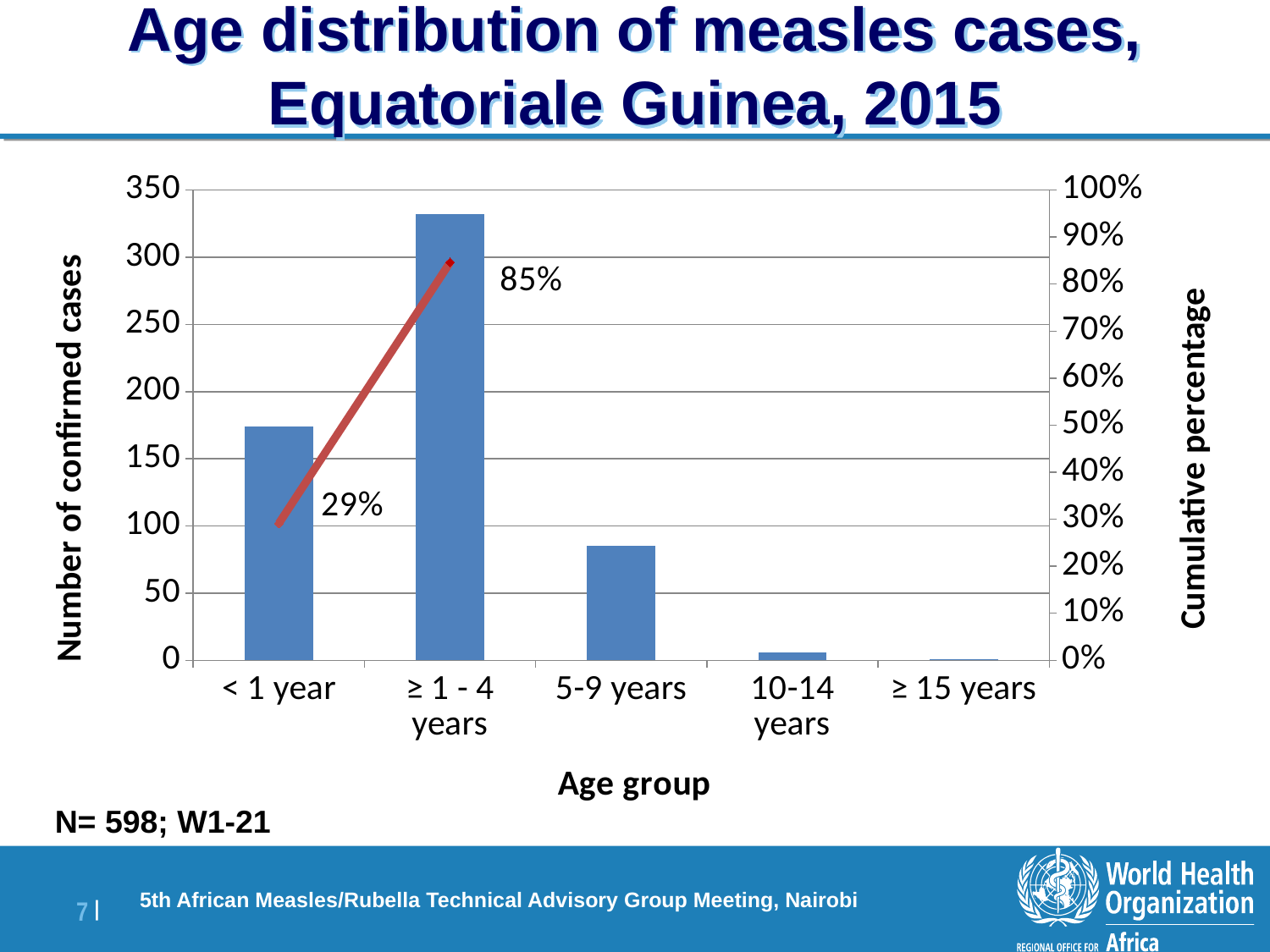
Is the number of confirmed cases for ≥ 1 - 4 years greater or less than 300? greater What is the difference between the cumulative percentages at ≥ 1 - 4 years and < 1 year? 56% Which age group has the highest number of confirmed cases? ≥ 1 - 4 years What kind of chart is shown on the slide? bar chart with a line Is the number of confirmed cases for < 1 year greater or less than 150? greater What is the cumulative percentage shown for the < 1 year age group? 29% How many age groups are shown on the x axis? 5 What is the title of the right-hand vertical axis? Cumulative percentage Which age group has the lowest number of confirmed cases? ≥ 15 years What is the cumulative percentage shown for the ≥ 1 - 4 years age group? 85% Which has more confirmed cases, < 1 year or 5-9 years? < 1 year Is the number of confirmed cases for 5-9 years greater or less than 100? less